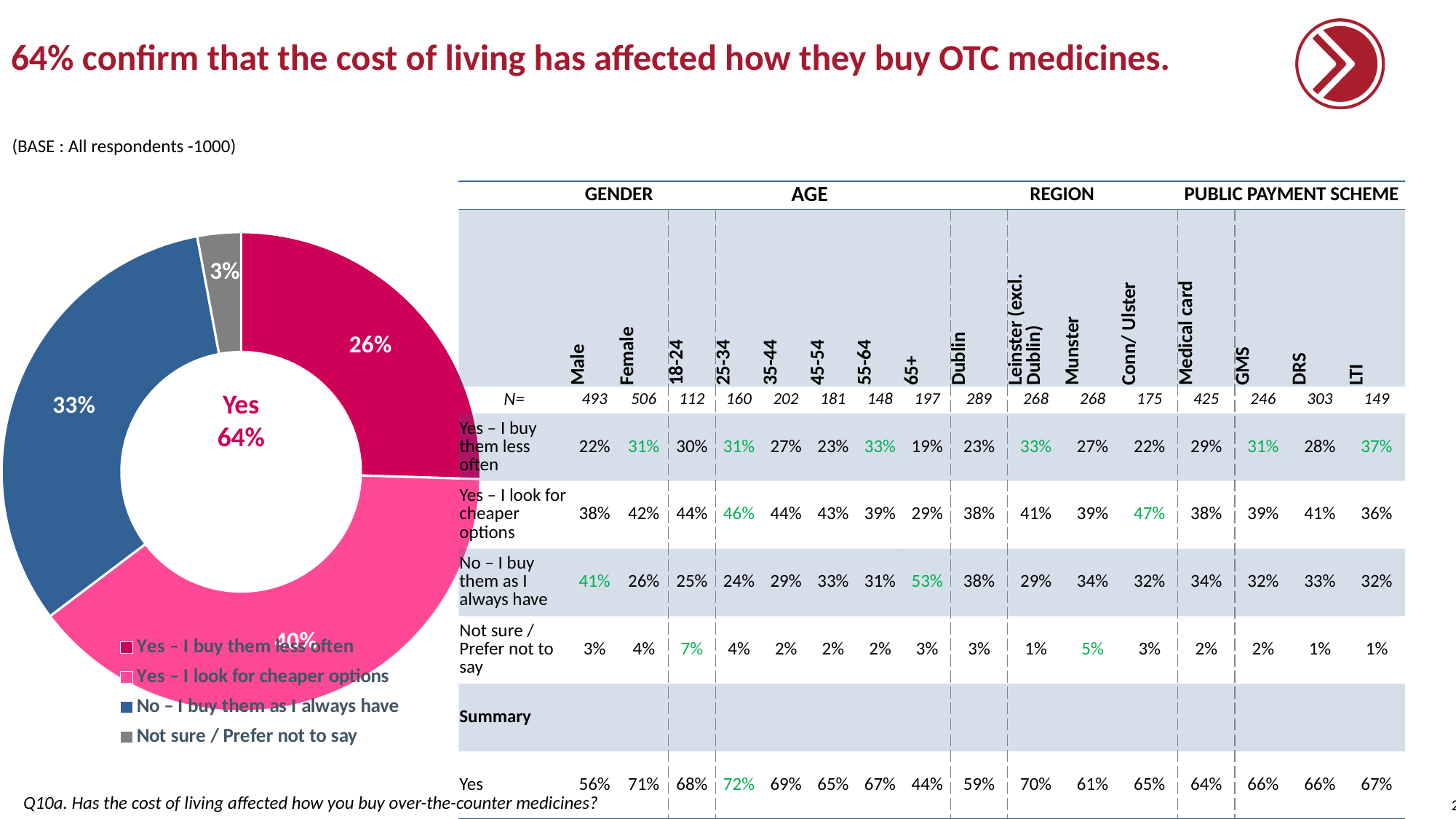
What kind of chart is shown on the left of the slide? pie chart (doughnut) What percentage of respondents said "Yes – I buy them less often"? 26% How many entries are listed in the pie chart's legend? 4 What colour is the "Not sure / Prefer not to say" slice in the pie chart? grey What value is shown in the centre of the pie chart? Yes 64% Which is larger: the share for "Yes – I buy them less often" or for "No – I buy them as I always have"? No – I buy them as I always have What is the difference in percentage points between "No – I buy them as I always have" (33%) and "Yes – I buy them less often" (26%)? 7 percentage points Which response has the smallest slice in the pie chart? Not sure / Prefer not to say How many slices does the pie chart have? 4 Which response has the largest slice in the pie chart? Yes – I look for cheaper options What percentage of respondents said "No – I buy them as I always have"? 33% What percentage of respondents said "Not sure / Prefer not to say"? 3%